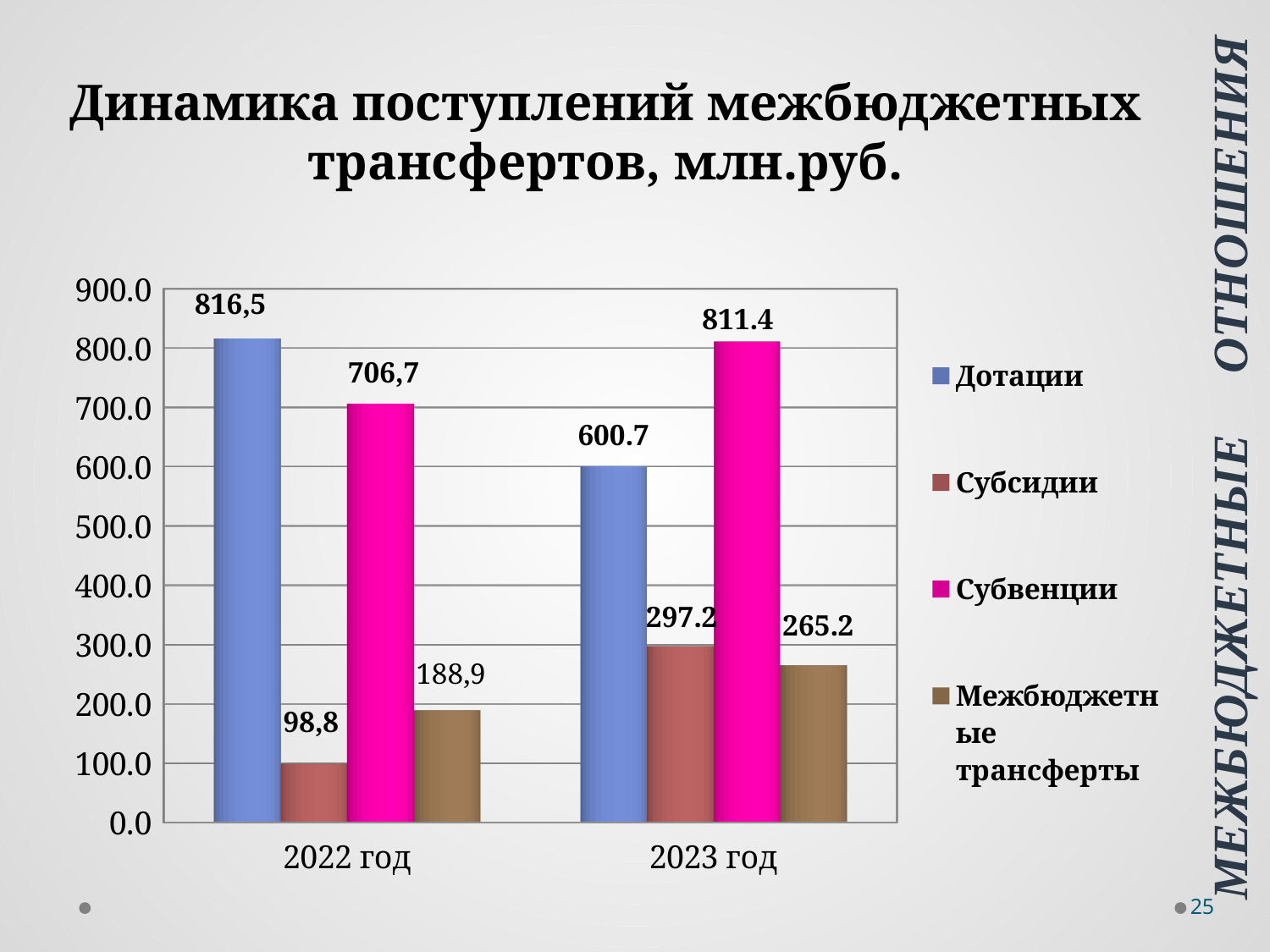
Do the values for Субсидии rise or fall from 2022 год to 2023 год? rise What is the value for Субсидии in 2022 год? 98,8 What is the value for Субвенции in 2023 год? 811.4 Which series has the highest value in 2023 год? Субвенции What is the difference between Субвенции in 2023 год and Дотации in 2023 год? 210.7 How many series does the legend list? 4 What is the value for Дотации in 2022 год? 816,5 What is the value for Межбюджетные трансферты in 2023 год? 265.2 What type of chart is shown on the slide? bar chart Which is larger: Дотации in 2022 год or Дотации in 2023 год? Дотации in 2022 год What is the difference between Дотации and Субвенции in 2022 год? 109,8 Which series has the lowest value in 2022 год? Субсидии